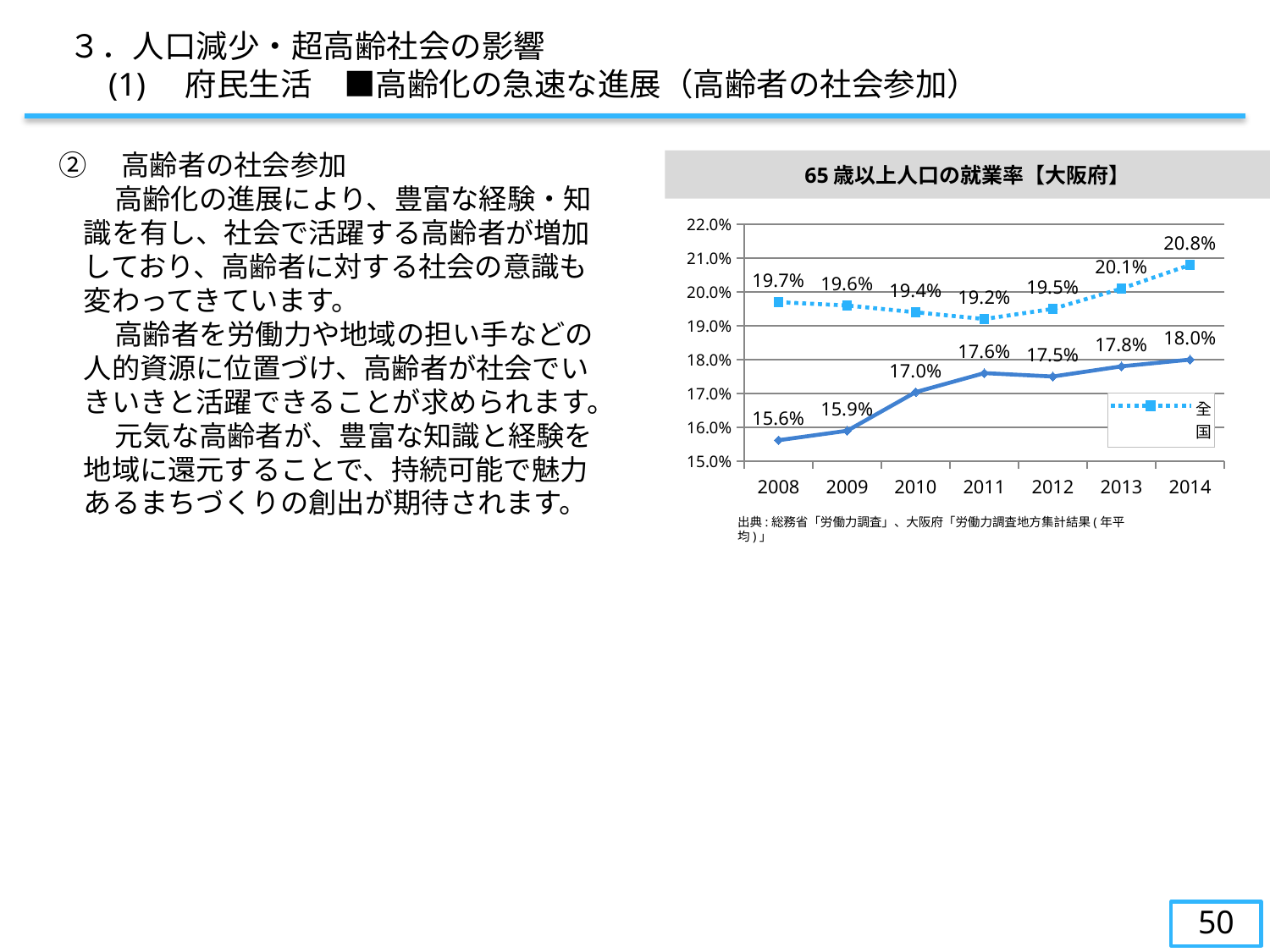
Which is larger in 2010, the 全国 (dotted) line or the solid line? 全国 (dotted) line How many years are shown on the x axis? 7 In which year is the solid (lower) line at its highest? 2014 In which year is the 全国 (dotted) line at its lowest? 2011 What is the difference between the 全国 line and the solid line in 2014? 2.8% What is the value of the 全国 (dotted) line in 2011? 19.2% What is the value of the solid (lower) line in 2012? 17.5% Does the solid (lower) line generally rise or fall from 2008 to 2014? rise What is the title of the chart? 65歳以上人口の就業率【大阪府】 What is the value of the solid (lower) line in 2008? 15.6% What is the value of the 全国 (dotted) line in 2014? 20.8% What kind of chart is shown on the slide? line chart